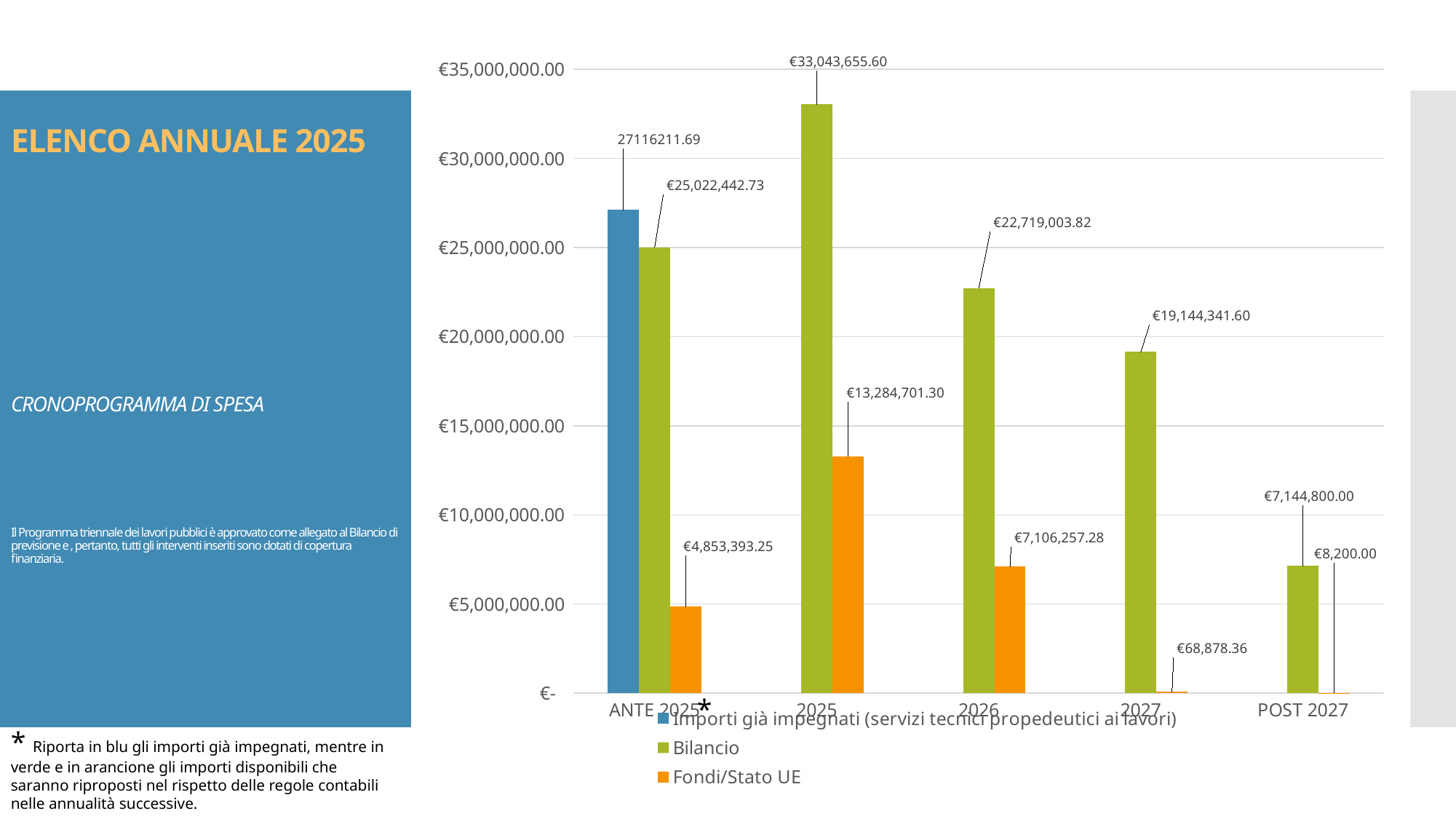
What is the difference between the Bilancio values for 2025 and 2026? €10,324,651.78 Which category has the lowest Fondi/Stato UE value? POST 2027 What type of chart is shown on the slide? bar chart How many series does the legend list? 3 Which category has the highest Bilancio value? 2025 Which colour represents the Fondi/Stato UE series? orange How many categories are shown on the x axis? 5 What is the Bilancio value for 2025? €33,043,655.60 What is the Fondi/Stato UE value for 2027? €68,878.36 Which is larger for 2026: Bilancio or Fondi/Stato UE? Bilancio What is the value of Importi già impegnati for ANTE 2025? 27116211.69 Does the Bilancio value rise or fall from 2025 to POST 2027? fall